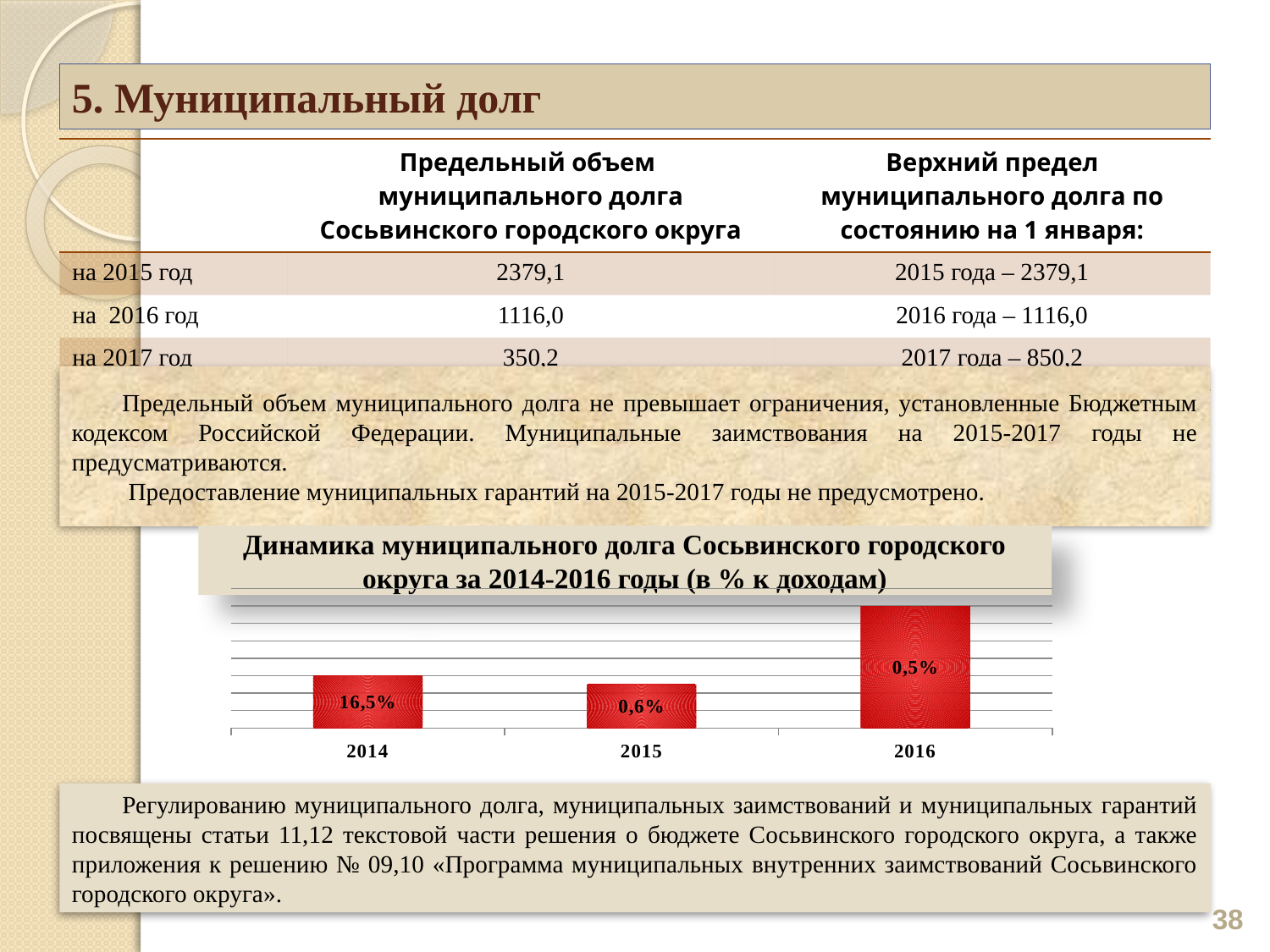
What is the value shown for 2014 in the chart? 16,5% What is the value shown for 2016 in the chart? 0,5% What is the title of the chart? Динамика муниципального долга Сосьвинского городского округа за 2014-2016 годы (в % к доходам) What is the value shown for 2015 in the chart? 0,6% How many years are plotted in the chart? 3 What is the difference between the labelled values for 2015 and 2016? 0,1% What is the difference between the labelled values for 2014 and 2015? 15,9% Which years appear on the x axis of the chart? 2014, 2015, 2016 What colour are the bars in the chart? Red What kind of chart is shown on the slide? Bar chart